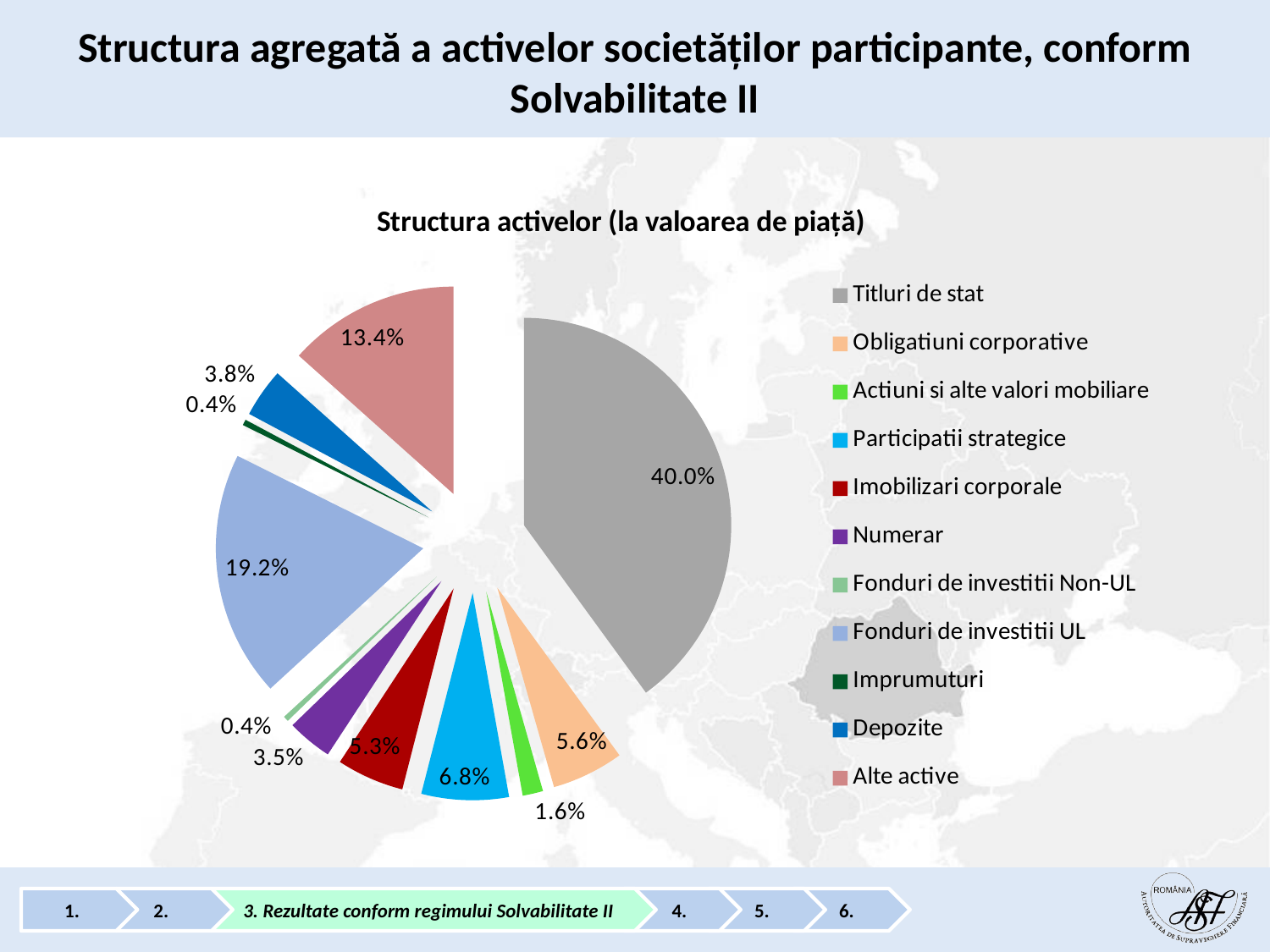
What is the combined share of Numerar and Actiuni si alte valori mobiliare? 5.1% What is the difference between the shares of Titluri de stat and Fonduri de investitii UL? 20.8% What share of the pie is Depozite? 3.8% What is the title of the chart? Structura activelor (la valoarea de piață) What share of the pie is Fonduri de investitii UL? 19.2% What share of the pie is Alte active? 13.4% What share of the pie is Titluri de stat? 40.0% How many categories does the legend list? 11 Which category has the largest share of the pie? Titluri de stat What share of the pie is Participatii strategice? 6.8% Which is larger, Obligatiuni corporative or Imobilizari corporale? Obligatiuni corporative What type of chart is shown on the slide? pie chart